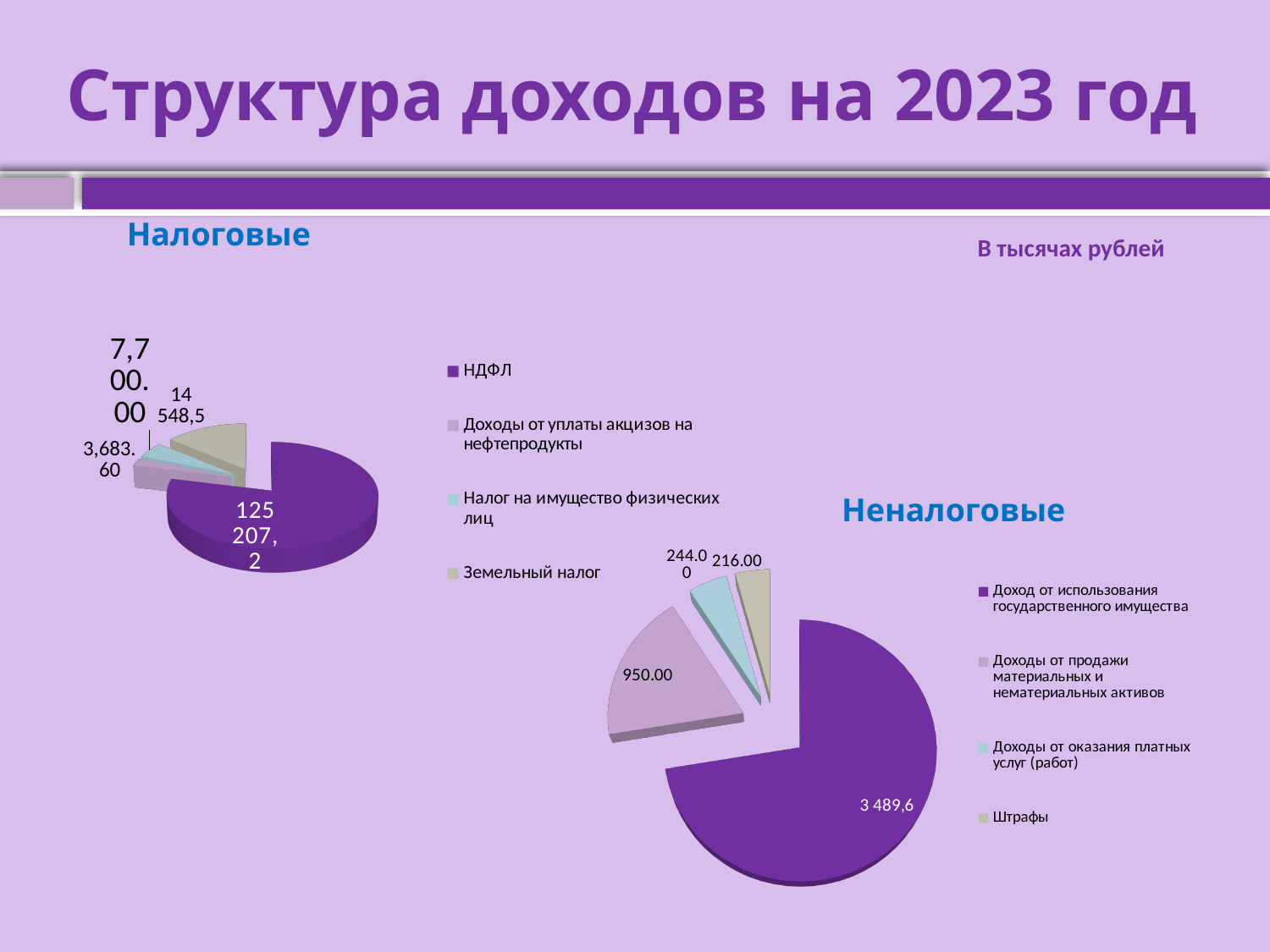
On the Налоговые chart, what value is shown for НДФЛ? 125 207,2 How many categories does the legend of the Неналоговые chart list? 4 On the Неналоговые chart, what is the difference between the values for Доходы от оказания платных услуг (работ) and Штрафы? 28.00 On the Неналоговые chart, which category has the smallest slice? Штрафы On the Неналоговые chart, what value is shown for Доход от использования государственного имущества? 3 489,6 On the Неналоговые chart, which is larger: Доходы от продажи материальных и нематериальных активов or Доходы от оказания платных услуг (работ)? Доходы от продажи материальных и нематериальных активов On the Налоговые chart, what value is shown for Земельный налог? 14 548,5 What type of chart is the Налоговые chart? Pie chart On the Налоговые chart, which category has the largest slice? НДФЛ On the Налоговые chart, which category has the smallest slice? Доходы от уплаты акцизов на нефтепродукты On the Налоговые chart, what value is shown for Налог на имущество физических лиц? 7,700.00 On the Неналоговые chart, what value is shown for Штрафы? 216.00